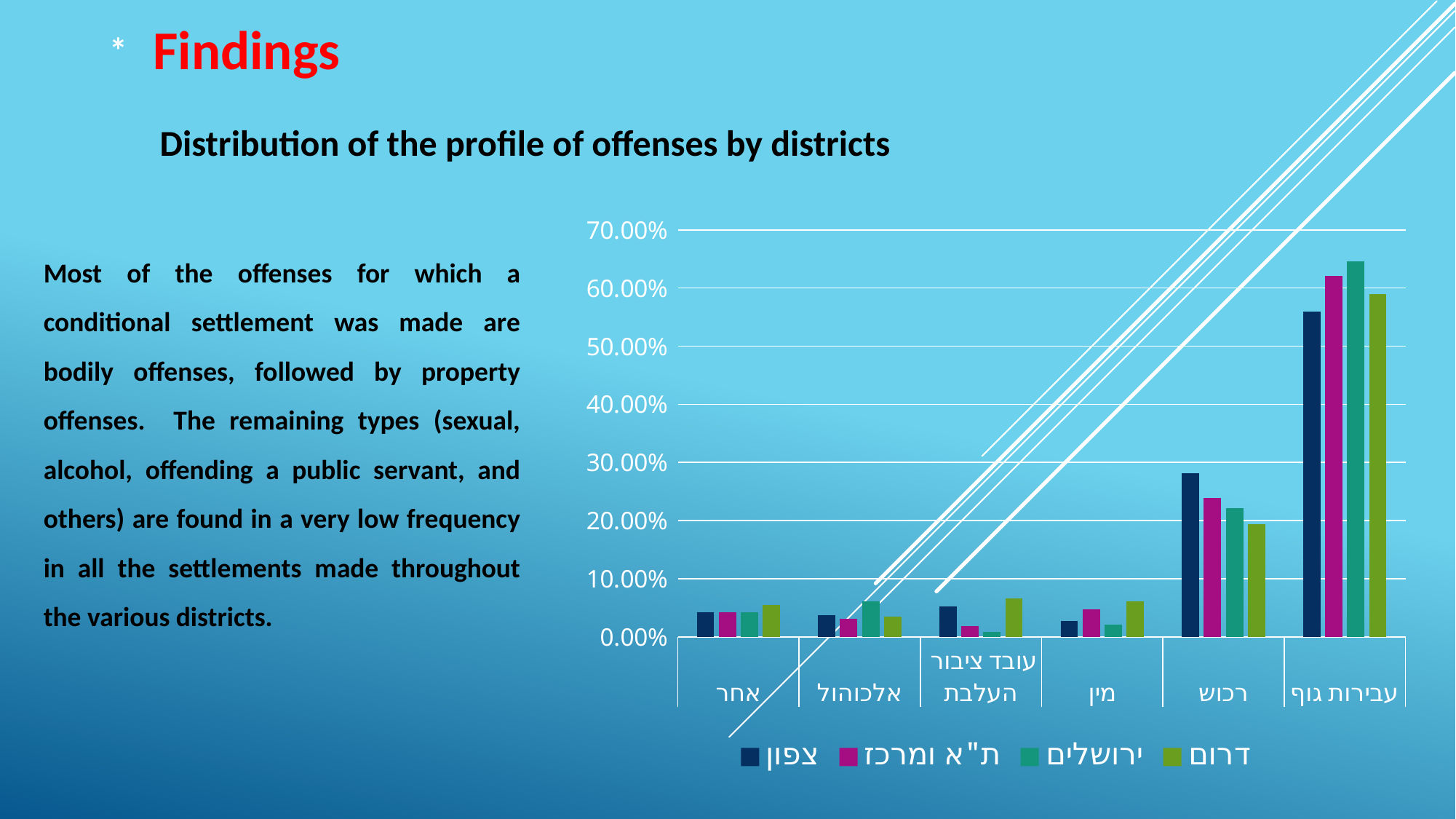
How many series does the chart legend list? 4 What kind of chart is shown on the slide? bar chart Is the value for צפון in the עבירות גוף category greater or less than 60%? less Is the value for צפון in the רכוש category greater or less than 20%? greater In the רכוש category, which series has the larger value: צפון or ירושלים? צפון In the עבירות גוף category, which series has the larger value: ירושלים or דרום? ירושלים Is the value for ירושלים in the עבירות גוף category greater or less than 60%? greater Which offense category has the highest bars in the chart? עבירות גוף Which series has the highest value in the רכוש category? צפון How many offense categories are shown on the x axis of the chart? 6 What is the title of the chart on the slide? Distribution of the profile of offenses by districts